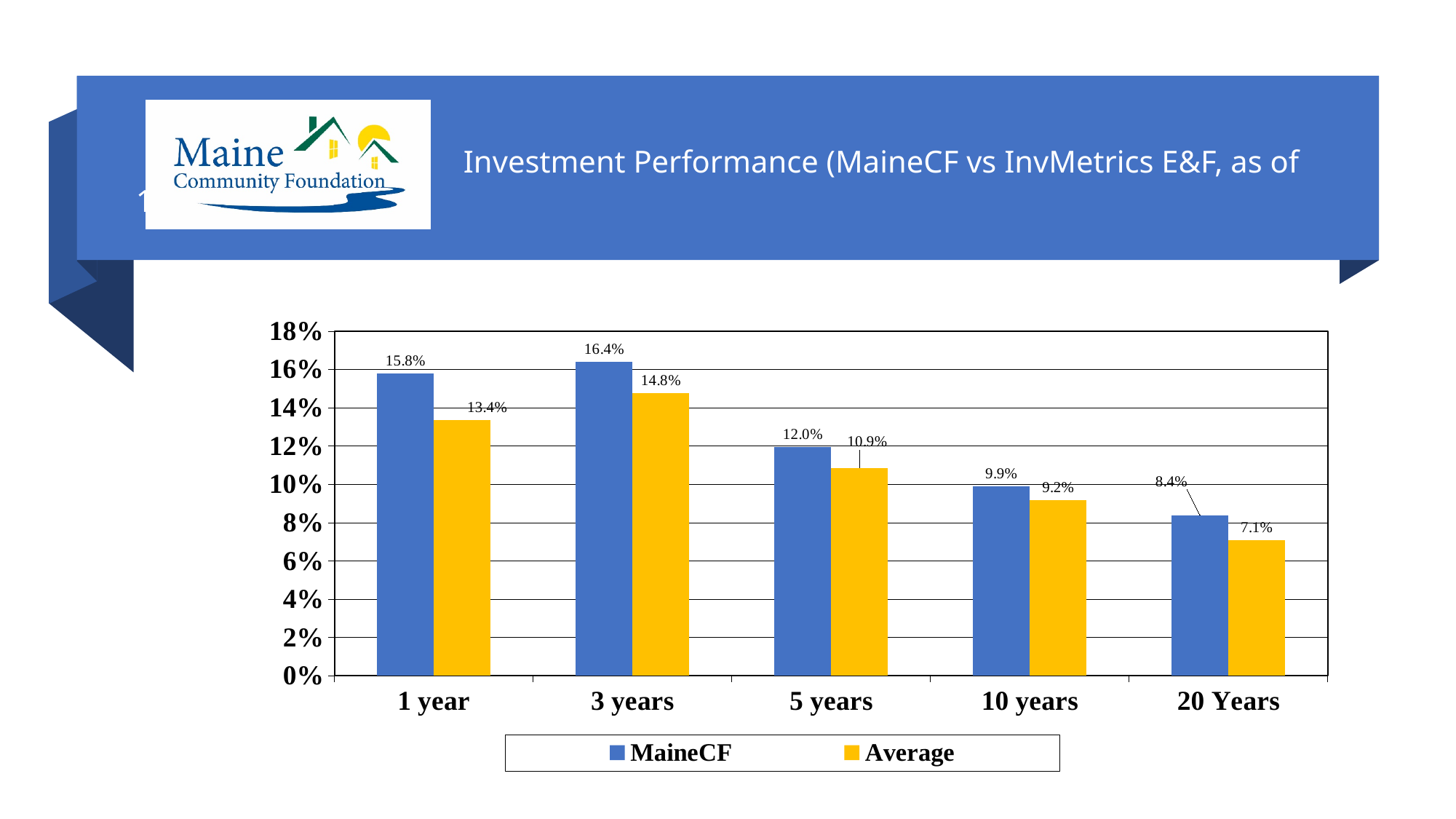
Which is larger for 1 year, MaineCF or Average? MaineCF Which period has the highest MaineCF value? 3 years How many series does the legend list? 2 How many periods are shown on the x axis? 5 What is the MaineCF value for 1 year? 15.8% Which period has the lowest Average value? 20 Years Do the MaineCF values rise or fall from 3 years to 20 Years? Fall What is the MaineCF value for 20 Years? 8.4% What kind of chart is shown? Bar chart What is the difference between the MaineCF and Average values for 5 years? 1.1% What is the Average value for 10 years? 9.2% What is the Average value for 3 years? 14.8%